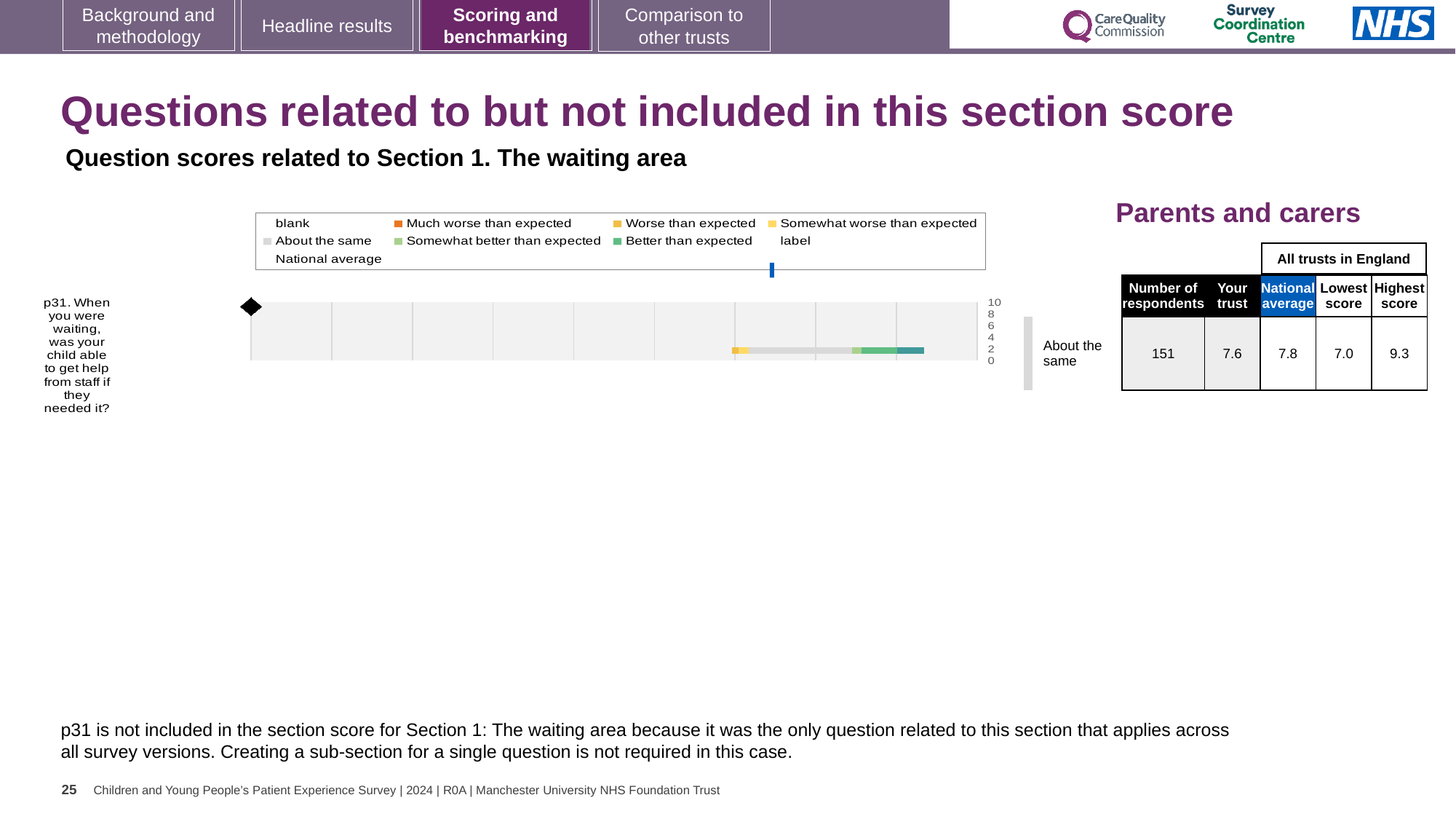
In the table beside the chart, what is the Highest score across all trusts in England for p31? 9.3 In the table beside the chart, what is the Lowest score across all trusts in England for p31? 7.0 What is the difference between the Highest score and the Lowest score for p31? 2.3 What benchmark category is shown next to the bar for p31? About the same In the table beside the chart, what is the 'Your trust' score for p31? 7.6 Which is larger for p31, the Your trust score or the National average score? National average Which question is plotted in the chart? p31. When you were waiting, was your child able to get help from staff if they needed it? In the table beside the chart, what is the National average score for p31? 7.8 What kind of chart is used to show the p31 question score? bar chart How many respondents answered p31 according to the table beside the chart? 151 How many questions are plotted in the chart? 1 Which legend entry is shown in orange? Much worse than expected